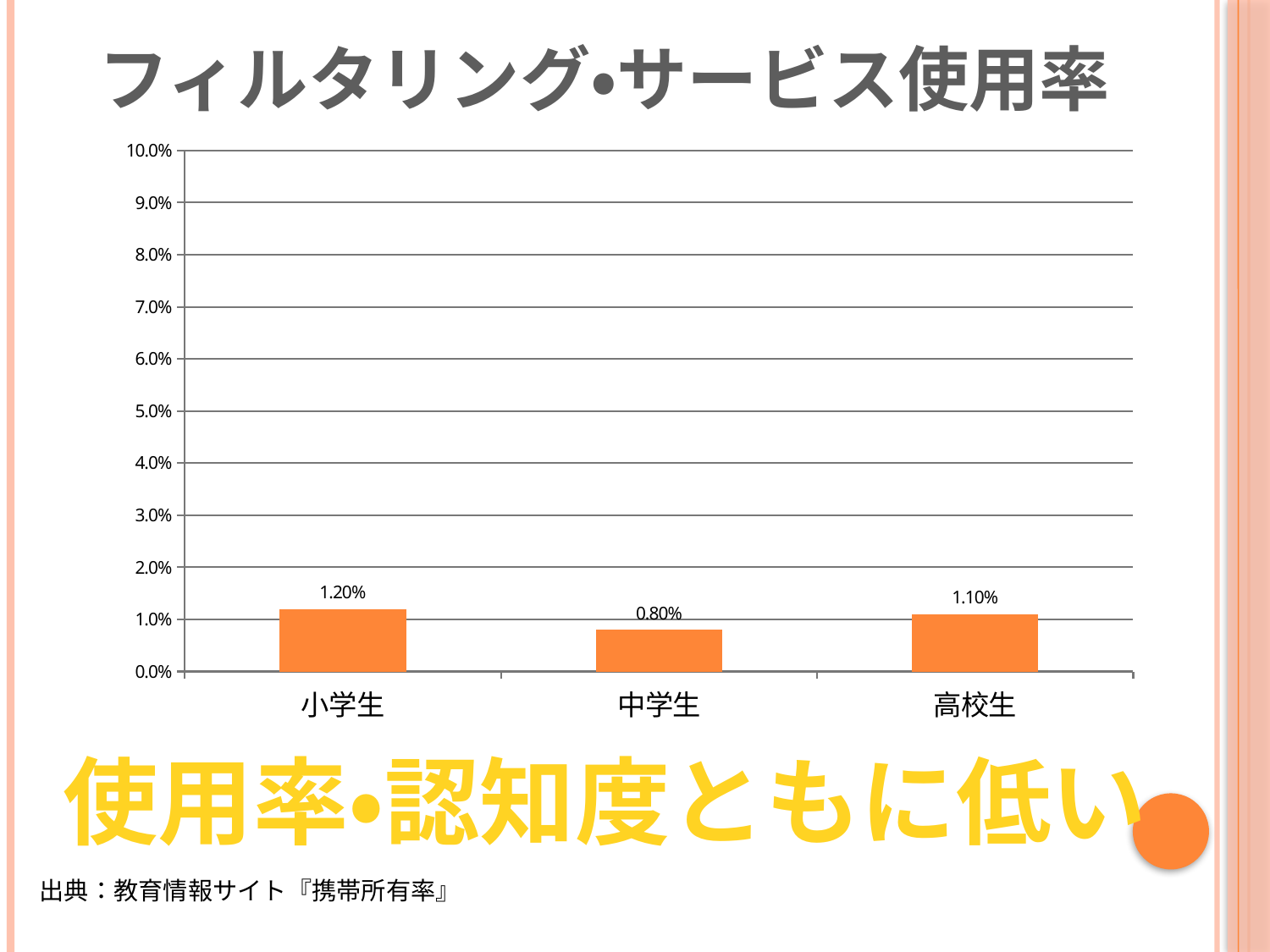
Which is larger, the value for 小学生 or the value for 高校生? 小学生 What is the difference between the values for 高校生 and 中学生? 0.30% Is the value for 中学生 greater or less than 1.0%? less What kind of chart is shown on the slide? bar chart What is the value for 小学生? 1.20% What is the difference between the values for 小学生 and 中学生? 0.40% What is the title of the chart? フィルタリング•サービス使用率 Which category has the highest value? 小学生 What is the value for 中学生? 0.80% How many categories are shown on the x axis? 3 Which category has the lowest value? 中学生 What is the value for 高校生? 1.10%